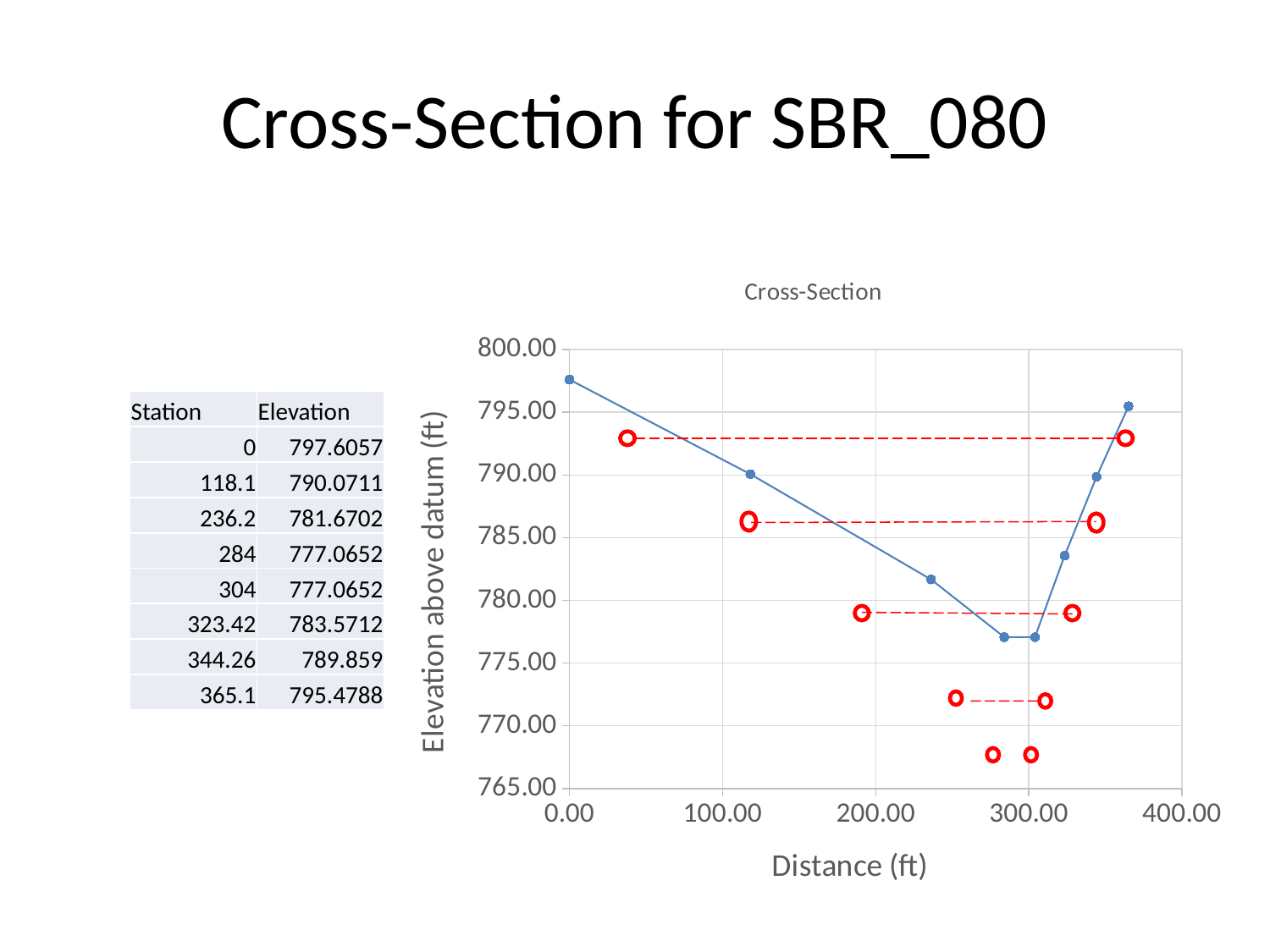
What is the elevation at station 365.1? 795.4788 What is the title of the chart? Cross-Section What type of chart is shown on the slide? line chart What is the elevation at station 323.42? 783.5712 Which has the higher elevation, station 118.1 or station 344.26? station 118.1 At which station is the elevation highest? 0 What is the elevation at station 0? 797.6057 Is the elevation at station 236.2 greater or less than 785.00? less What is the lowest elevation value plotted on the chart? 777.0652 What is the difference in elevation between station 0 and station 365.1? 2.1269 How many blue data points are plotted on the cross-section line? 8 What is the label of the vertical axis of the chart? Elevation above datum (ft)